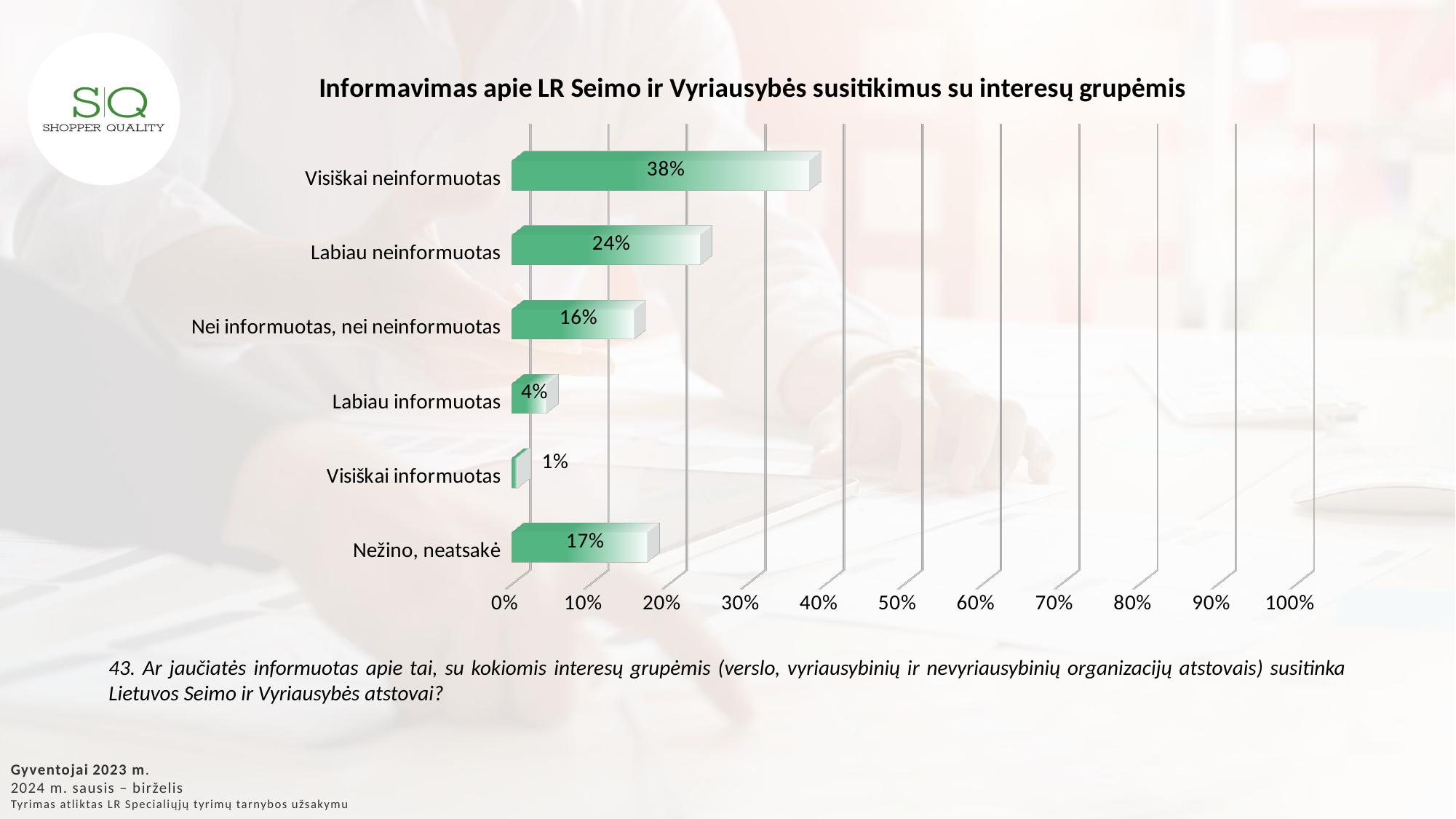
What is the title of the chart? Informavimas apie LR Seimo ir Vyriausybės susitikimus su interesų grupėmis Which category has the lowest value? Visiškai informuotas Which is larger, "Nežino, neatsakė" or "Nei informuotas, nei neinformuotas"? Nežino, neatsakė Is the value for "Labiau neinformuotas" greater or less than 20%? greater What is the value for "Labiau neinformuotas"? 24% What is the difference between "Visiškai neinformuotas" and "Labiau neinformuotas"? 14% What kind of chart is shown on the slide? bar chart What is the value for "Nežino, neatsakė"? 17% Which category has the highest value? Visiškai neinformuotas How many categories are shown in the chart? 6 What is the value for "Nei informuotas, nei neinformuotas"? 16% What is the value for "Visiškai neinformuotas"? 38%